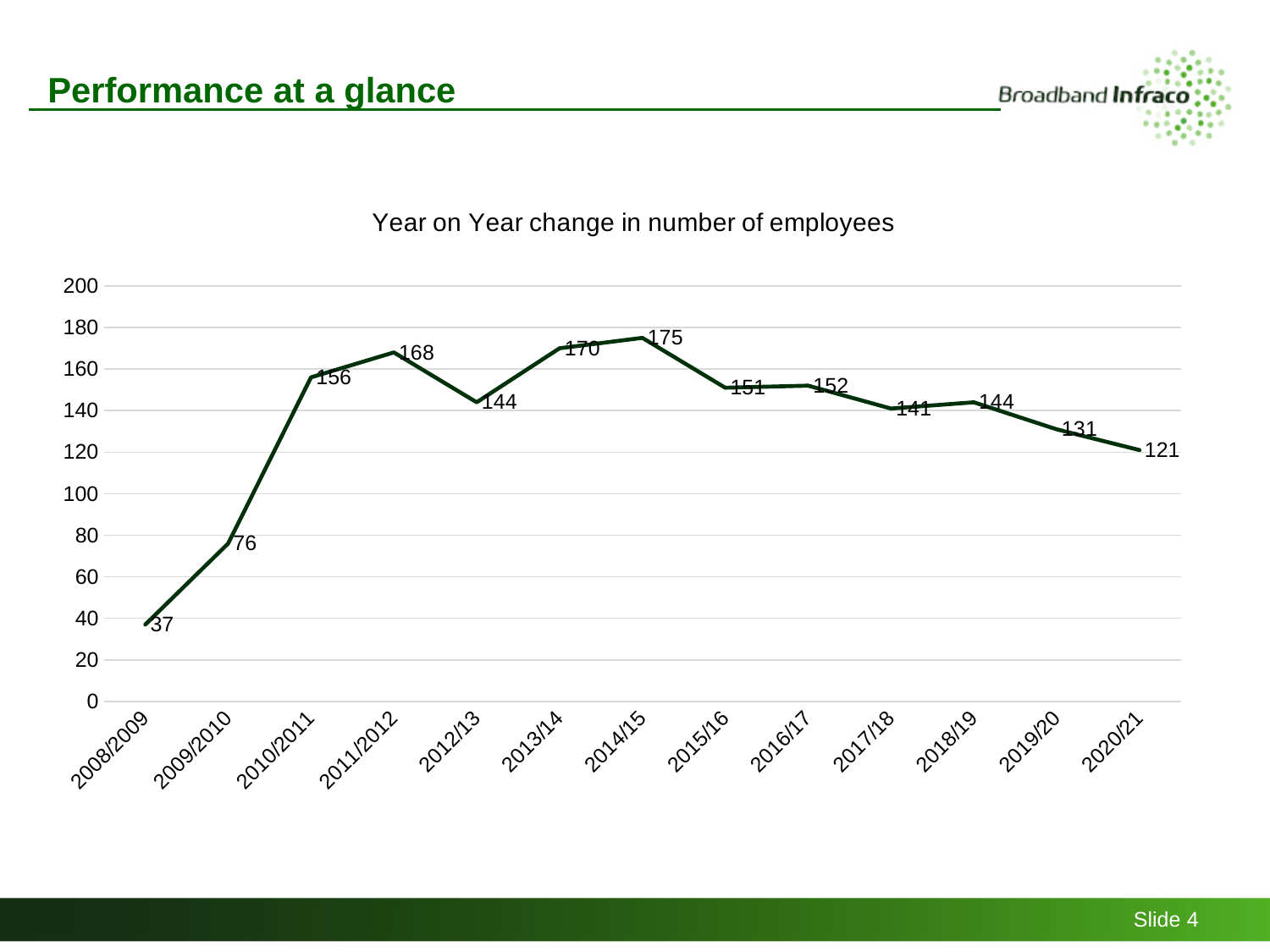
Which year has the highest number of employees? 2014/15 How many years are plotted on the chart? 13 What is the number of employees for 2020/21? 121 What is the title of the chart? Year on Year change in number of employees Do the values rise or fall from 2014/15 to 2020/21? Fall Which year has more employees, 2011/2012 or 2012/13? 2011/2012 What is the number of employees for 2014/15? 175 What kind of chart is shown on the slide? Line chart What is the difference in number of employees between 2009/2010 and 2010/2011? 80 What is the number of employees for 2008/2009? 37 What is the difference in number of employees between 2014/15 and 2020/21? 54 Which year has the lowest number of employees? 2008/2009